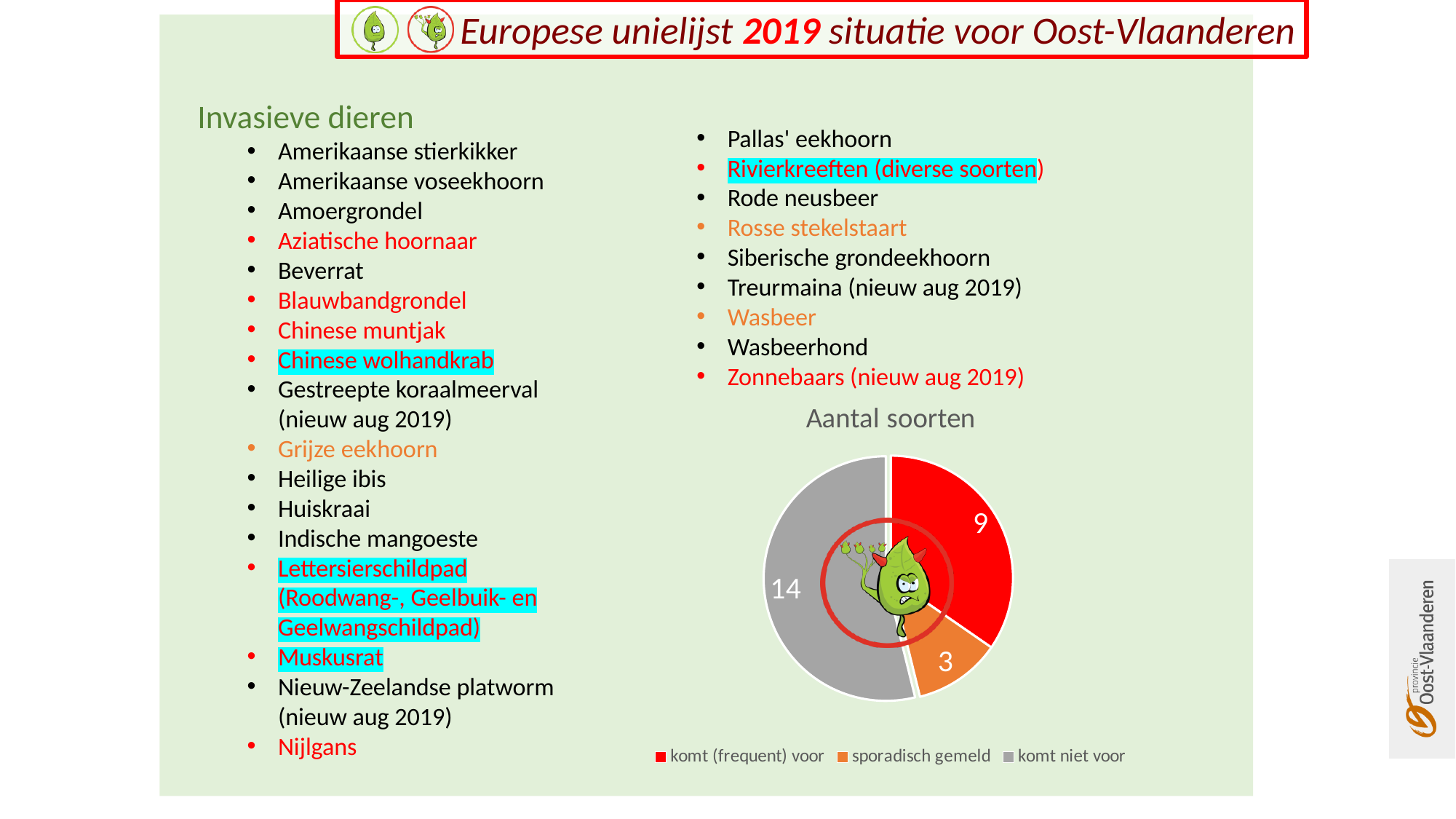
Which category has the smallest slice in the "Aantal soorten" pie chart? sporadisch gemeld In the "Aantal soorten" pie chart, what is the difference between the values for "komt niet voor" and "komt (frequent) voor"? 5 In the "Aantal soorten" pie chart, what is the value for "sporadisch gemeld"? 3 What is the title of the pie chart on the slide? Aantal soorten How many slices does the "Aantal soorten" pie chart have? 3 In the "Aantal soorten" pie chart, what is the value for "komt (frequent) voor"? 9 Which category has the largest slice in the "Aantal soorten" pie chart? komt niet voor In the "Aantal soorten" pie chart, which is larger: "komt (frequent) voor" or "sporadisch gemeld"? komt (frequent) voor What is the total of all slices in the "Aantal soorten" pie chart? 26 What colour is the "komt niet voor" slice in the "Aantal soorten" pie chart? grey What kind of chart is shown under the title "Aantal soorten"? pie chart In the "Aantal soorten" pie chart, what is the value for "komt niet voor"? 14